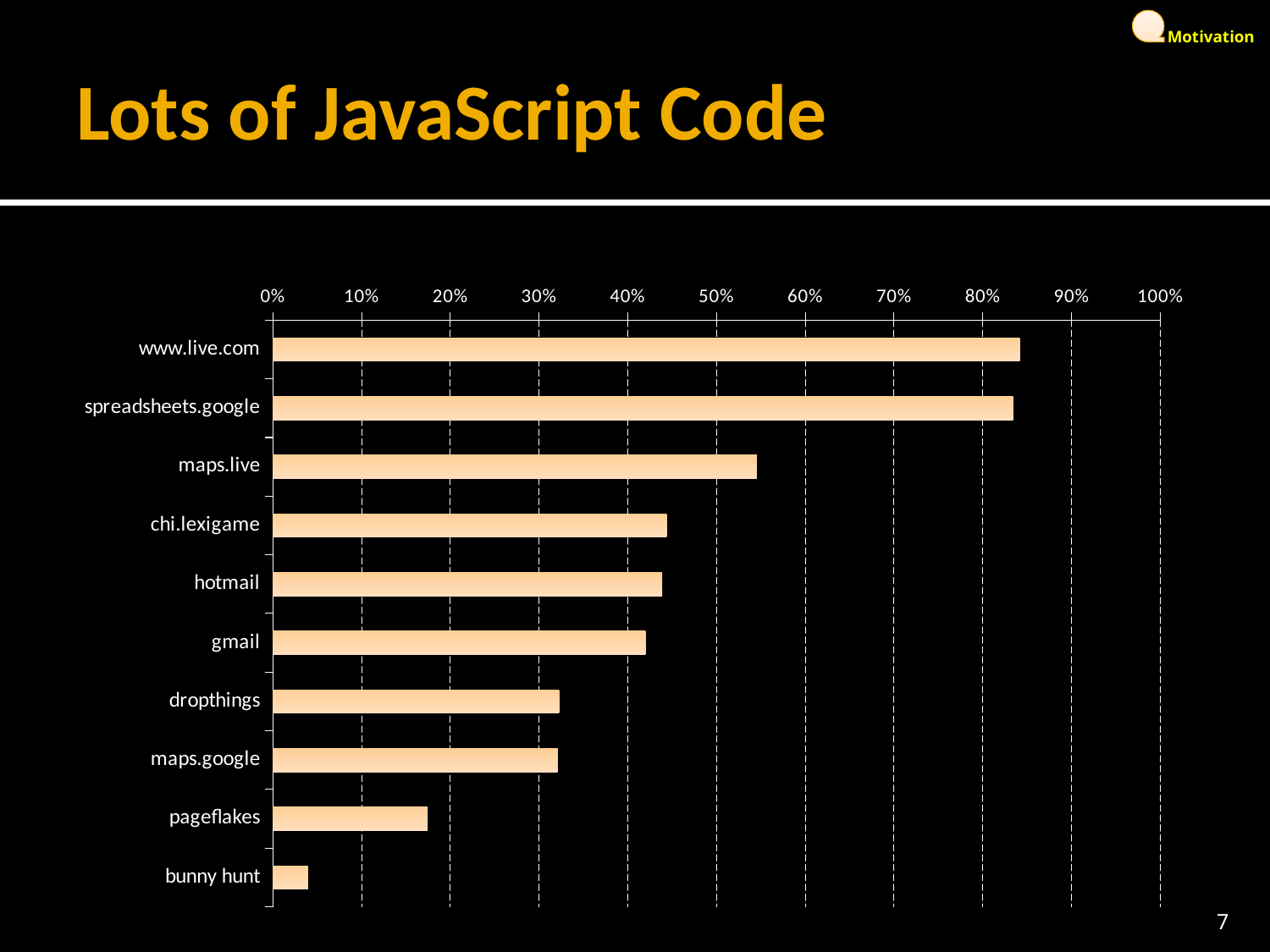
Is the value for bunny hunt greater or less than 10%? less Is the value for hotmail greater or less than 50%? less Is the value for www.live.com greater or less than 80%? greater Which has the larger value, gmail or dropthings? gmail What is the title of the slide containing the chart? Lots of JavaScript Code How many categories (websites) are plotted in the chart? 10 Which category has the lowest value in the chart? bunny hunt What kind of chart is shown on the slide? bar chart Which has the larger value, maps.live or chi.lexigame? maps.live